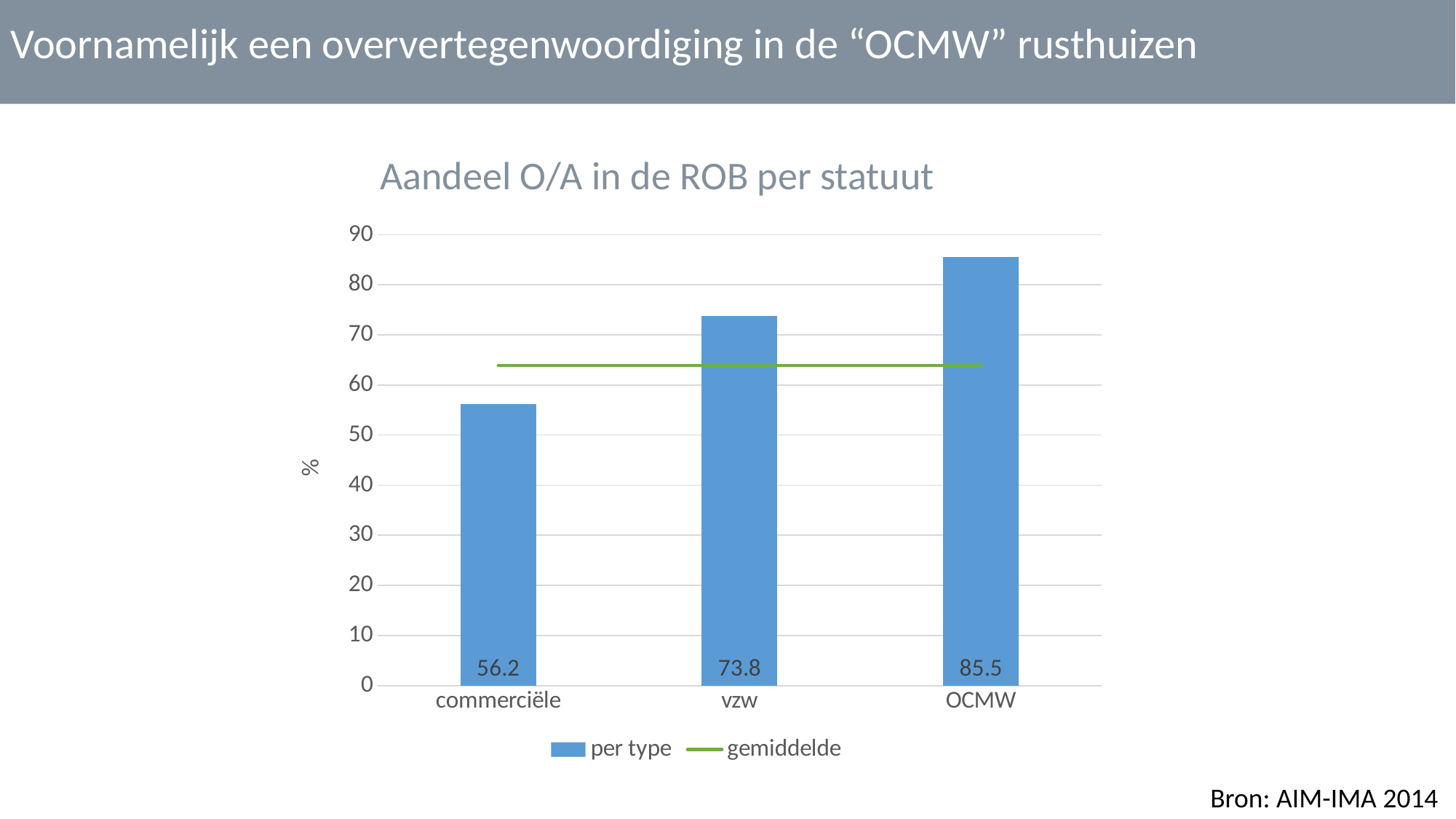
What is the difference between the values for vzw and commerciële? 17.6 Is the gemiddelde line greater or less than 60? greater What is the title of the chart? Aandeel O/A in de ROB per statuut What is the value for commerciële? 56.2 Which category has the highest value? OCMW How many series does the legend list? 2 Which category has the lowest value? commerciële How many categories are shown on the x axis? 3 What is the value for vzw? 73.8 What is the value for OCMW? 85.5 Which is larger, the value for vzw or the value for OCMW? OCMW What is the difference between the values for OCMW and commerciële? 29.3